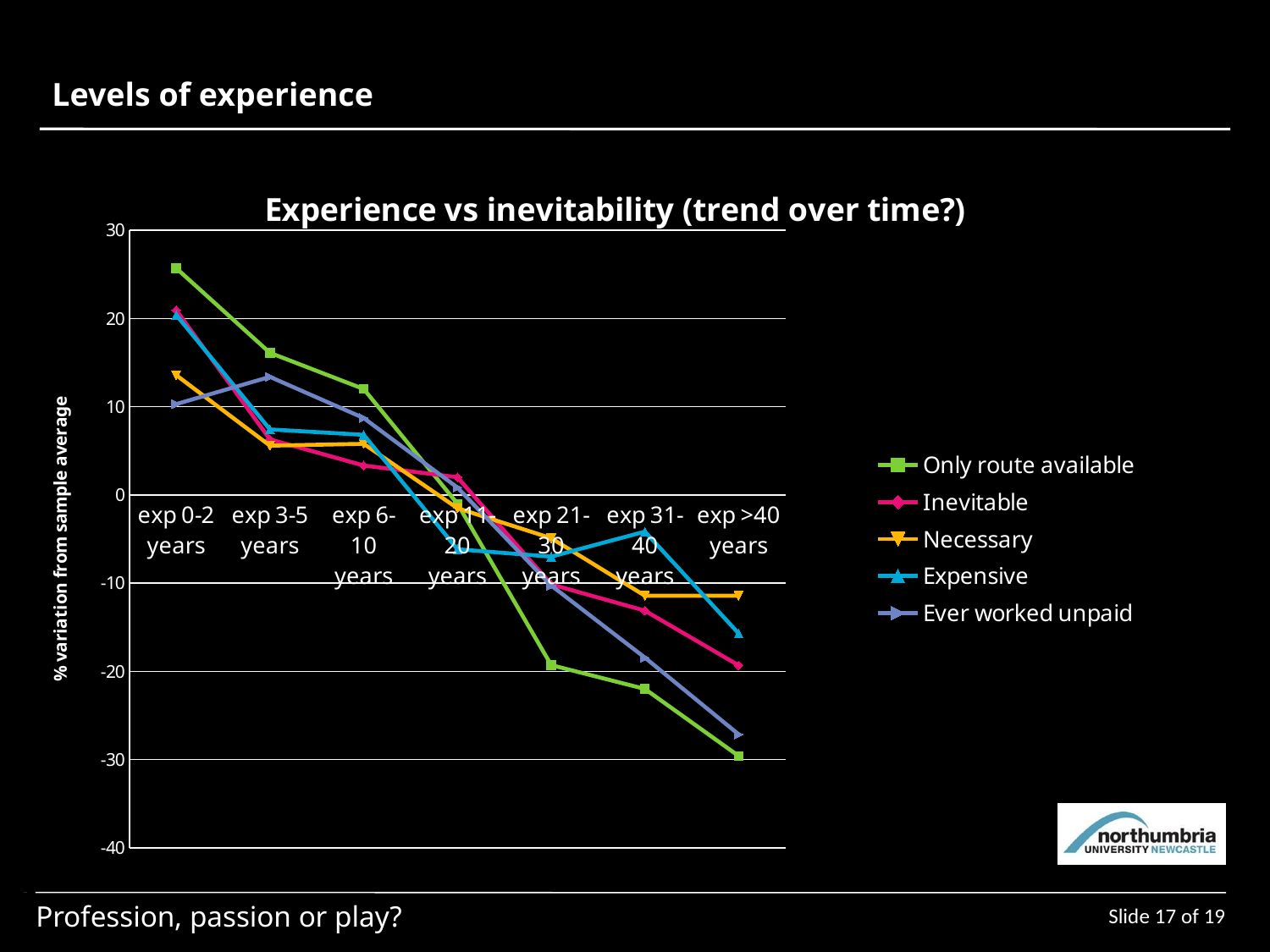
Does the 'Only route available' series rise or fall as experience increases along the x axis? fall Is the value for 'Only route available' at exp >40 years greater or less than -20? less How many experience categories are shown on the x axis? 7 Which series has the highest value at exp 0-2 years? Only route available Is the value for 'Expensive' at exp >40 years greater or less than -10? less Is the value for 'Only route available' at exp 0-2 years greater or less than 20? greater What kind of chart is shown on the slide? line chart What is the label on the vertical axis? % variation from sample average At exp 3-5 years, which is larger: the value for 'Only route available' or the value for 'Necessary'? Only route available How many series does the legend list? 5 What is the title of the chart? Experience vs inevitability (trend over time?)